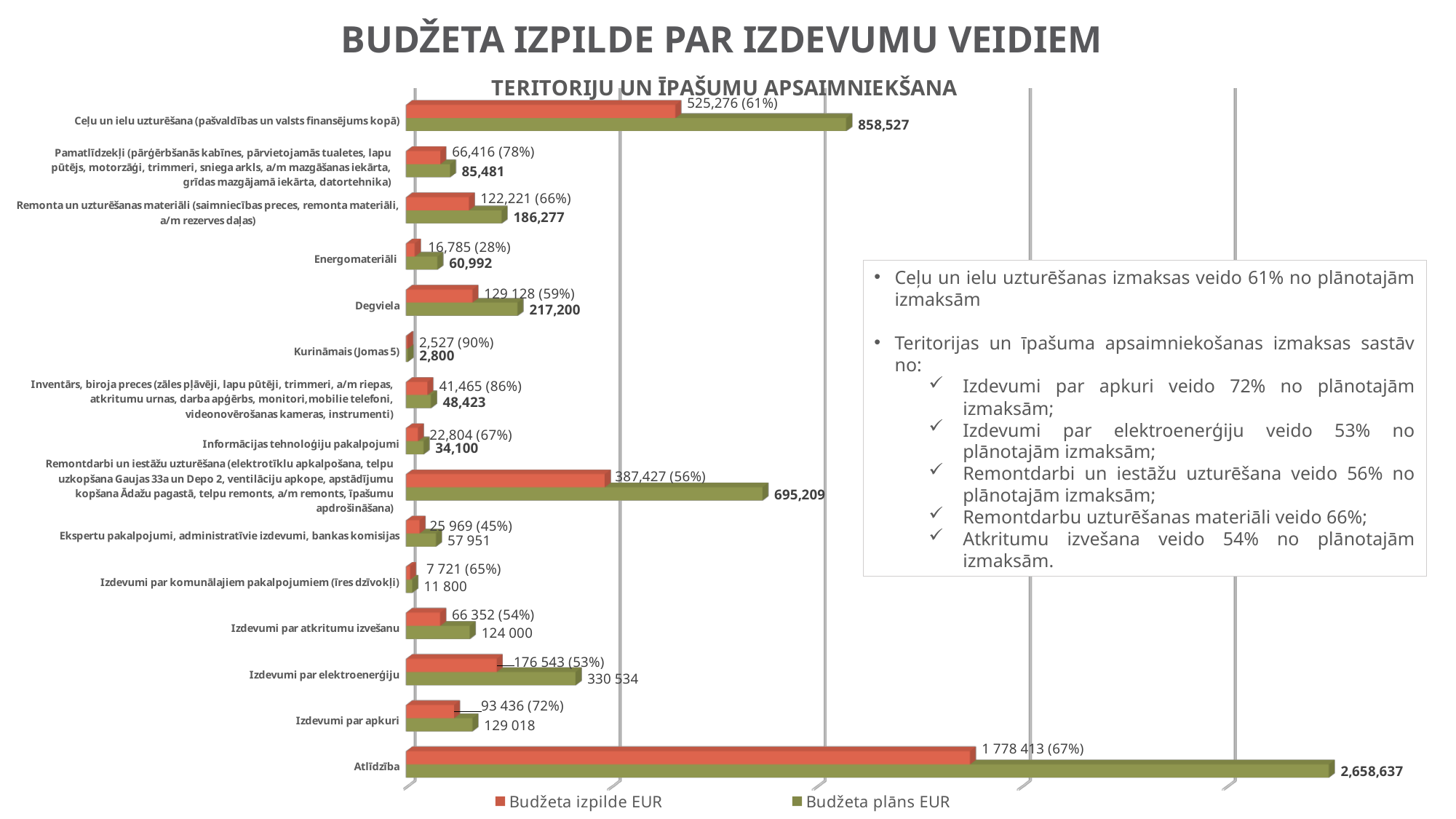
What percentage of the plan is shown next to the Budžeta izpilde bar for Energomateriāli? 28% What is the difference between the Budžeta plāns EUR and Budžeta izpilde EUR values for Energomateriāli? 44,207 Which category has the lowest Budžeta plāns EUR value? Kurināmais (Jomas 5) How many series does the legend list? 2 What is the Budžeta izpilde EUR value for Degviela? 129,128 What is the Budžeta plāns EUR value for Izdevumi par elektroenerģiju? 330 534 How many categories are shown on the chart? 15 What is the Budžeta plāns EUR value for Atlīdzība? 2,658,637 What type of chart is shown on the slide? Bar chart Which category has the highest Budžeta plāns EUR value? Atlīdzība What is the difference between the Budžeta plāns EUR and Budžeta izpilde EUR values for Izdevumi par atkritumu izvešanu? 57 648 Which has a larger Budžeta izpilde EUR value: Izdevumi par apkuri or Izdevumi par elektroenerģiju? Izdevumi par elektroenerģiju